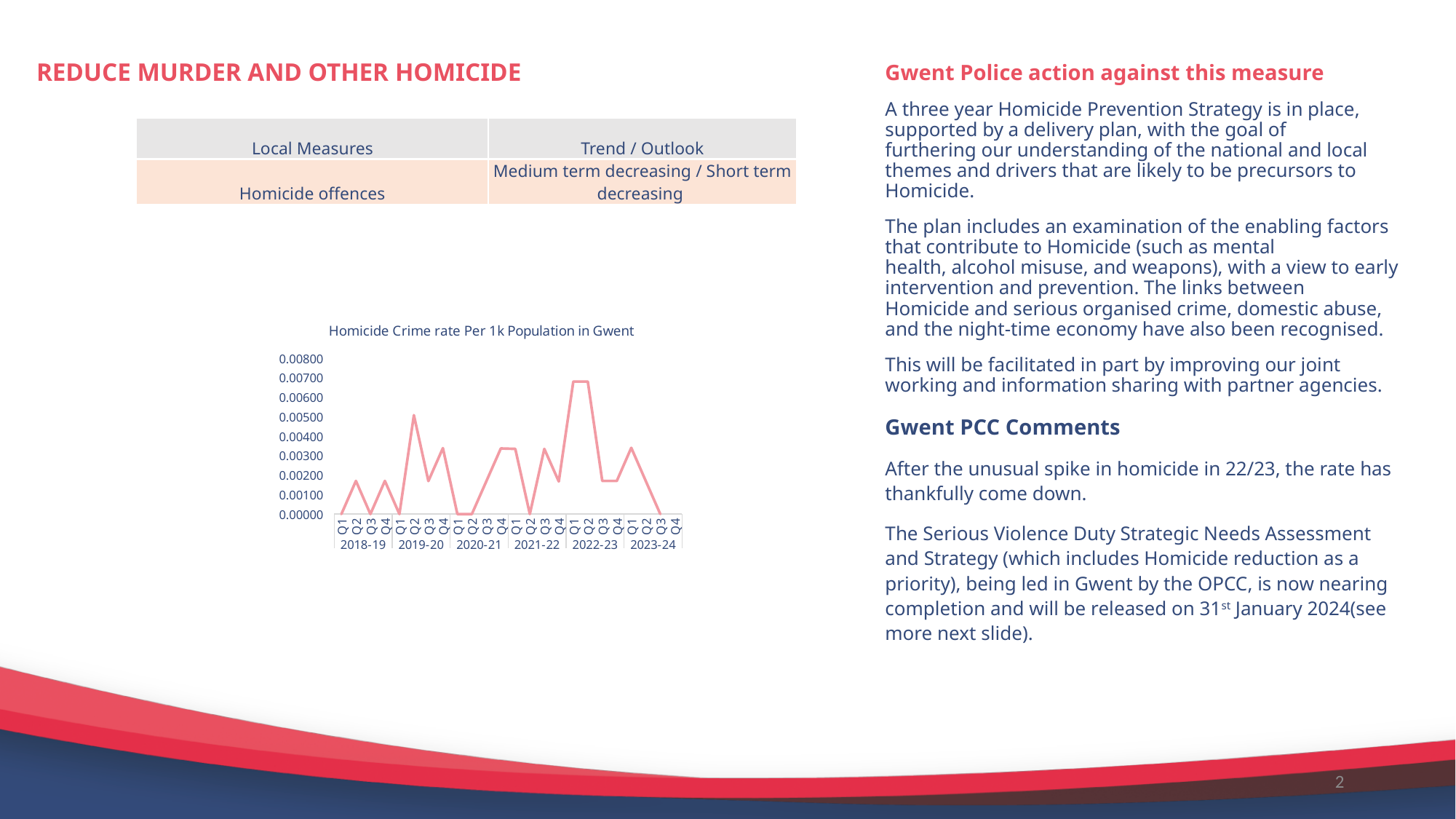
How many financial years are labelled along the x axis of the chart? 6 Is the value for Q2 2019-20 greater or less than 0.00400? greater Is the value for Q2 2018-19 greater or less than 0.00300? less Is the value for Q3 2023-24 greater or less than 0.00100? less Which is larger, the value for Q2 2019-20 or the value for Q1 2022-23? Q1 2022-23 Which is larger, the value for Q2 2018-19 or the value for Q2 2019-20? Q2 2019-20 Does the homicide crime rate rise or fall overall from Q2 2022-23 to Q3 2023-24? Fall What is the title of the chart on the slide? Homicide Crime rate Per 1k Population in Gwent In which financial year does the chart reach its highest homicide crime rate? 2022-23 What is the highest value shown on the chart's y axis? 0.00800 What kind of chart is shown on the slide? Line chart